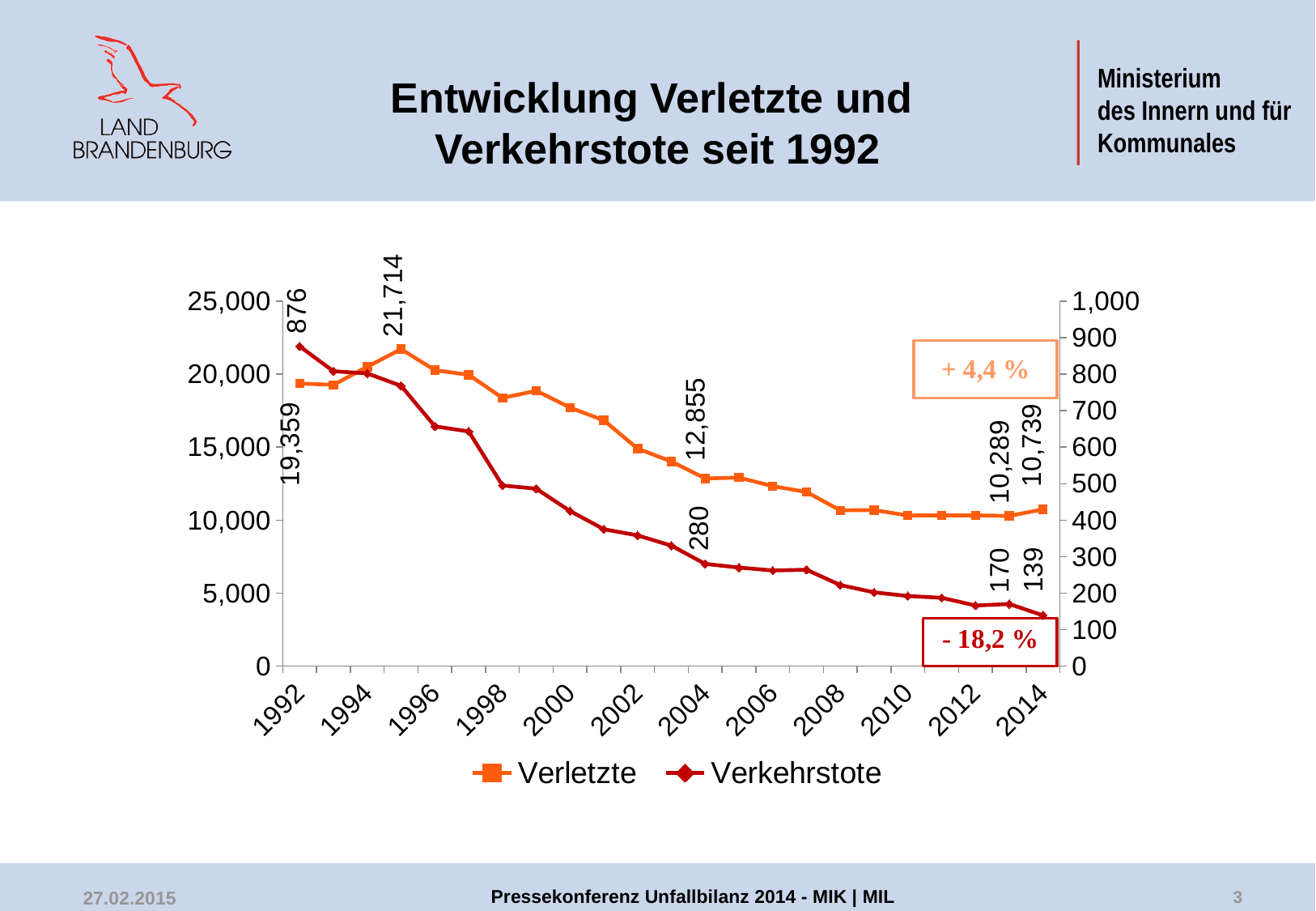
Is the Verkehrstote value in 2004 greater or less than the value in 2013? greater What type of chart is shown on the slide? line chart What is the difference between the Verletzte values in 2014 and 2013? 450 What was the number of Verletzte in 2014? 10,739 What was the number of Verkehrstote in 1992? 876 How many series does the legend list? 2 What is the difference between the Verkehrstote values in 2013 and 2014? 31 What percentage change is shown in the box next to the Verletzte series? + 4,4 % What was the number of Verletzte in 1992? 19,359 In which year did the Verletzte series reach its highest value? 1995 What was the number of Verkehrstote in 2014? 139 Does the Verkehrstote series generally rise or fall from 1992 to 2014? fall